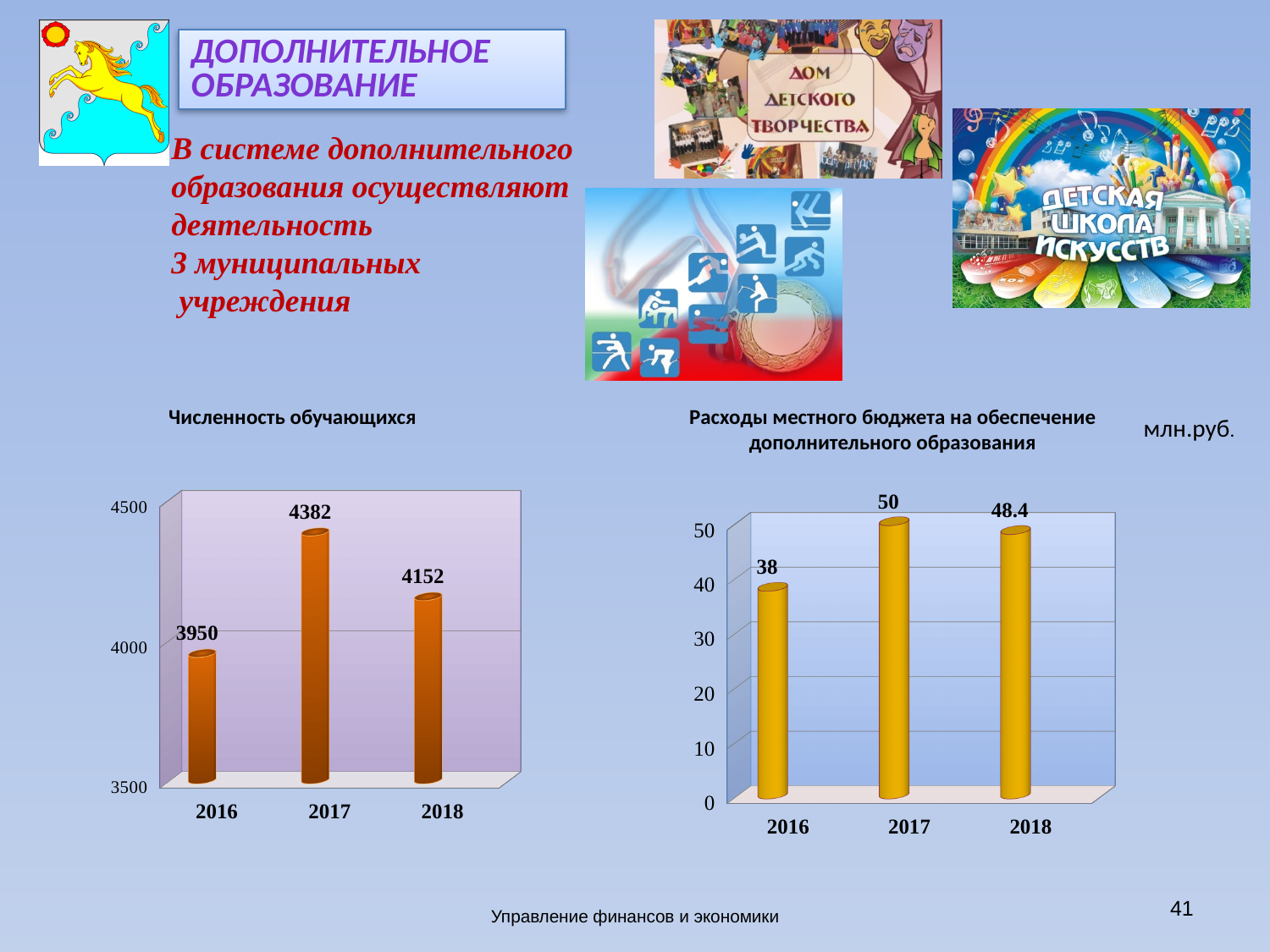
In the 'Численность обучающихся' chart, what is the value for 2016? 3950 In the 'Расходы местного бюджета на обеспечение дополнительного образования' chart, what is the value for 2018? 48.4 In the 'Расходы местного бюджета на обеспечение дополнительного образования' chart, what is the difference between the values for 2017 and 2016? 12 In the 'Расходы местного бюджета на обеспечение дополнительного образования' chart, which year has the highest value? 2017 In the 'Численность обучающихся' chart, how many years are shown? 3 In the 'Численность обучающихся' chart, which year has the lowest value? 2016 What kind of chart is the 'Расходы местного бюджета на обеспечение дополнительного образования' chart? bar chart In the 'Численность обучающихся' chart, what is the value for 2017? 4382 In the 'Расходы местного бюджета на обеспечение дополнительного образования' chart, what is the value for 2016? 38 In the 'Численность обучающихся' chart, which year has the highest value? 2017 In the 'Численность обучающихся' chart, what is the difference between the values for 2017 and 2018? 230 In the 'Расходы местного бюджета на обеспечение дополнительного образования' chart, is the value for 2016 larger or smaller than the value for 2018? smaller